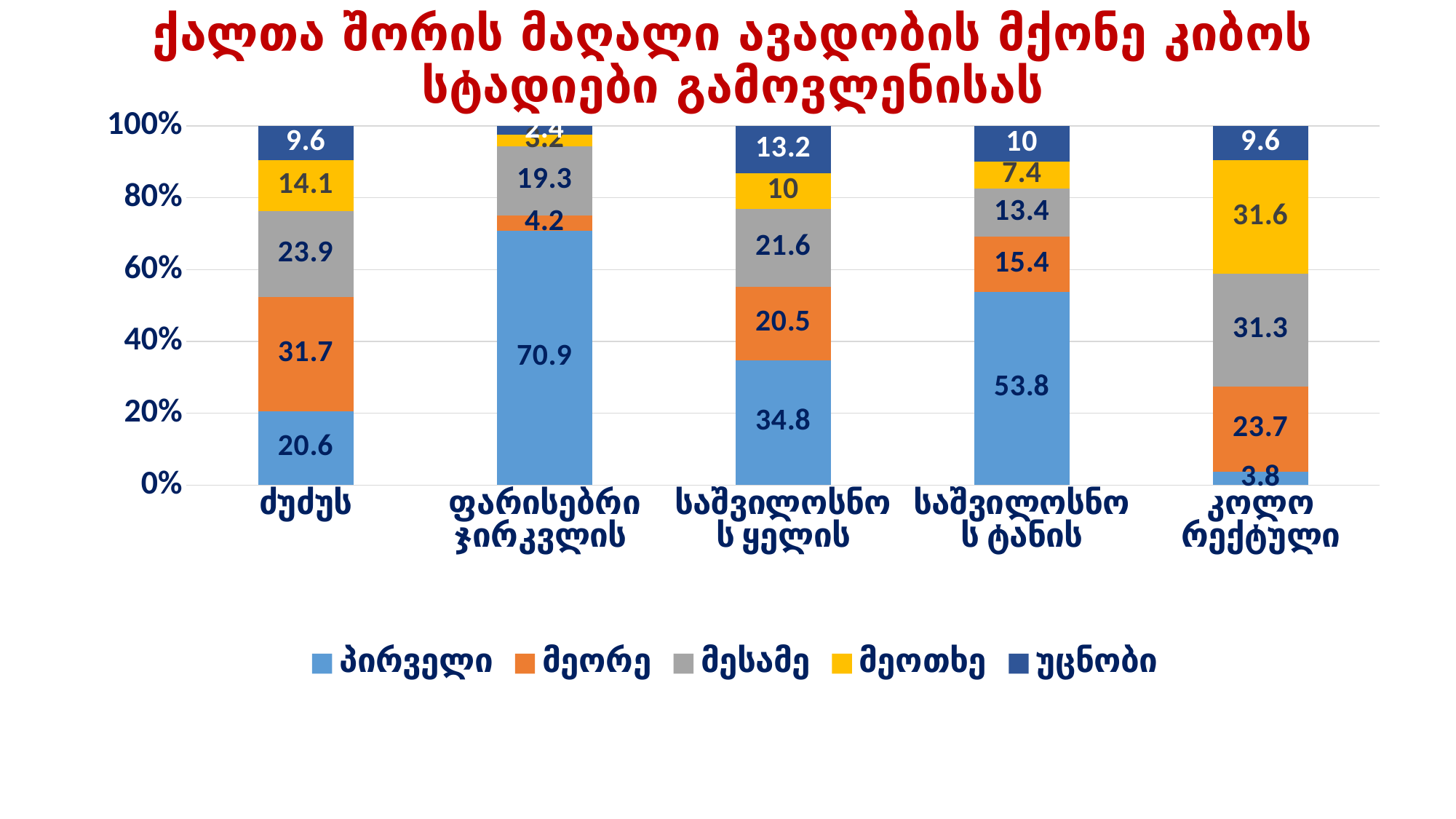
Which category has the lowest value for პირველი? კოლორექტული What is the value of პირველი for ფარისებრი ჯირკვლის? 70.9 Which is larger: the მესამე value for ძუძუს or the მესამე value for საშვილოსნოს ტანის? ძუძუს How many categories are shown on the x axis? 5 Which category has the highest value for პირველი? ფარისებრი ჯირკვლის What is the value of უცნობი for საშვილოსნოს ყელის? 13.2 What is the value of მეორე for ძუძუს? 31.7 How many series does the legend list? 5 What kind of chart is shown on the slide? Stacked bar chart Which series is shown in yellow in the legend? მეოთხე What is the difference between the პირველი values for საშვილოსნოს ტანის and საშვილოსნოს ყელის? 19 What is the value of მეოთხე for კოლორექტული? 31.6